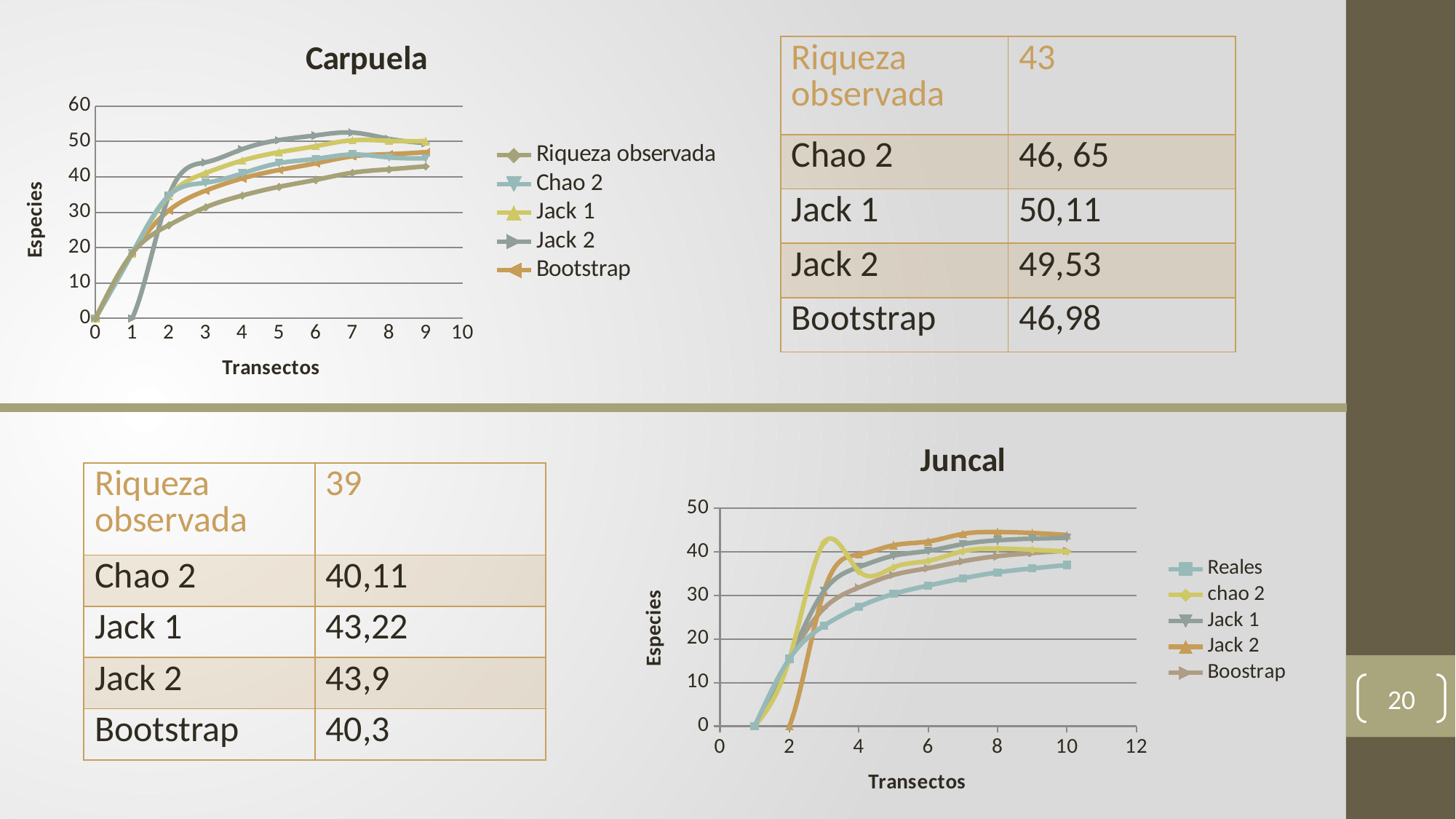
How many series does the legend of the Carpuela chart list? 5 In the Juncal chart, is the value of Jack 2 at transect 8 greater or less than 40? greater What kind of chart is the Carpuela chart? line chart What is the label of the y axis on the Juncal chart? Especies In the Juncal chart, is the value of Reales at transect 10 greater or less than 40? less In the Carpuela chart, is the value of Riqueza observada at transect 9 greater or less than 50? less In the Carpuela chart, at transect 1, which is larger: Jack 2 or Riqueza observada? Riqueza observada How many series does the legend of the Juncal chart list? 5 In the Carpuela chart, which series has the lowest value at transect 9? Riqueza observada In the Juncal chart, which series has the lowest value at transect 10? Reales In the Juncal chart, does the Reales series rise or fall as transects increase? rise